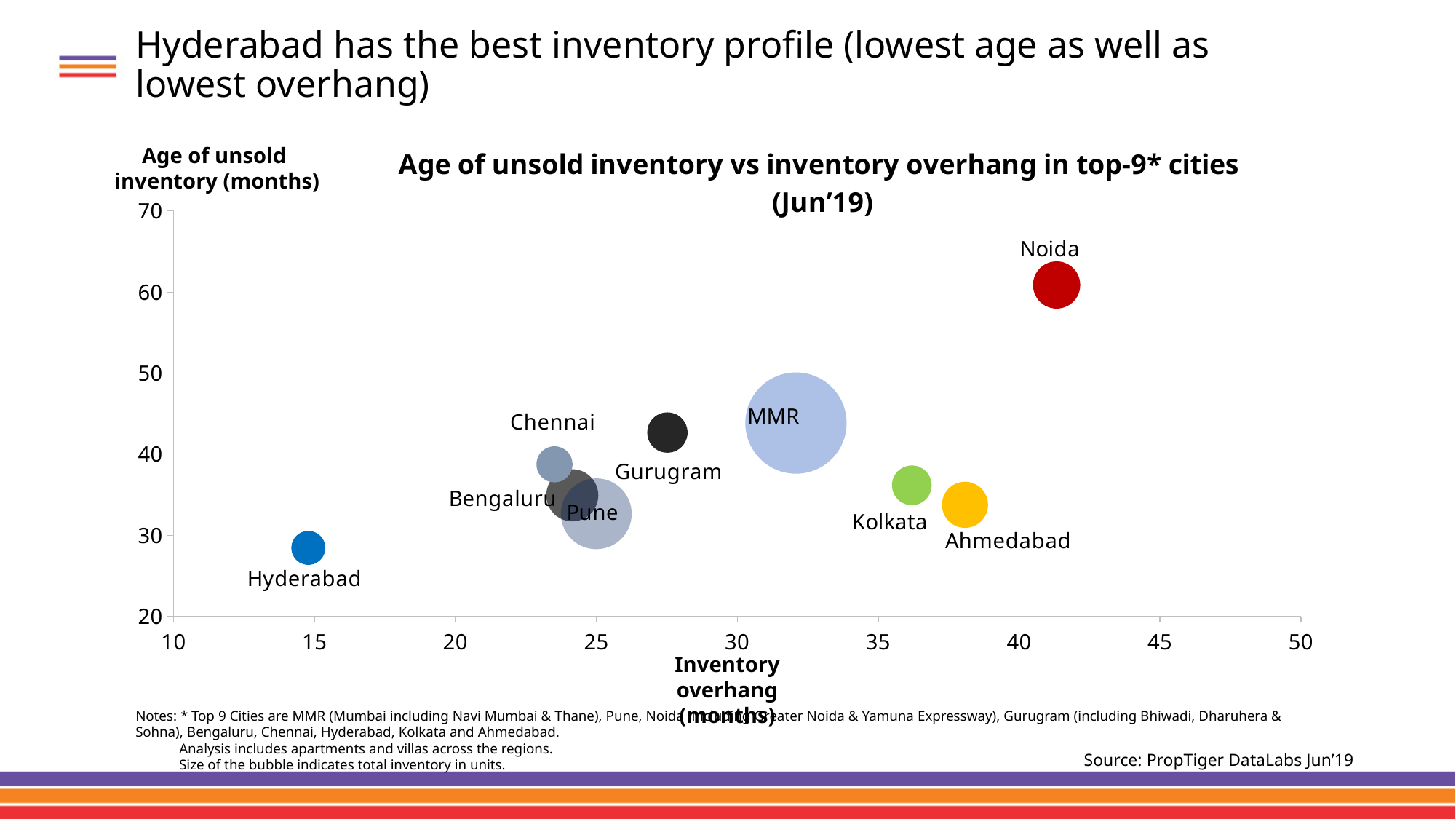
Which city has the highest age of unsold inventory? Noida What kind of chart is shown on the slide? Bubble chart Which city has a higher inventory overhang, Kolkata or Ahmedabad? Ahmedabad Which city has the highest inventory overhang? Noida Which city has the largest bubble, indicating the most total inventory in units? MMR Is the age of unsold inventory for Noida greater or less than 50 months? greater Which city has the lowest age of unsold inventory? Hyderabad How many cities are plotted in the chart? 9 Is the age of unsold inventory for Hyderabad greater or less than 30 months? less Which city has the lowest inventory overhang? Hyderabad What is the title of the chart? Age of unsold inventory vs inventory overhang in top-9* cities (Jun'19) Is the inventory overhang for MMR greater or less than 30 months? greater